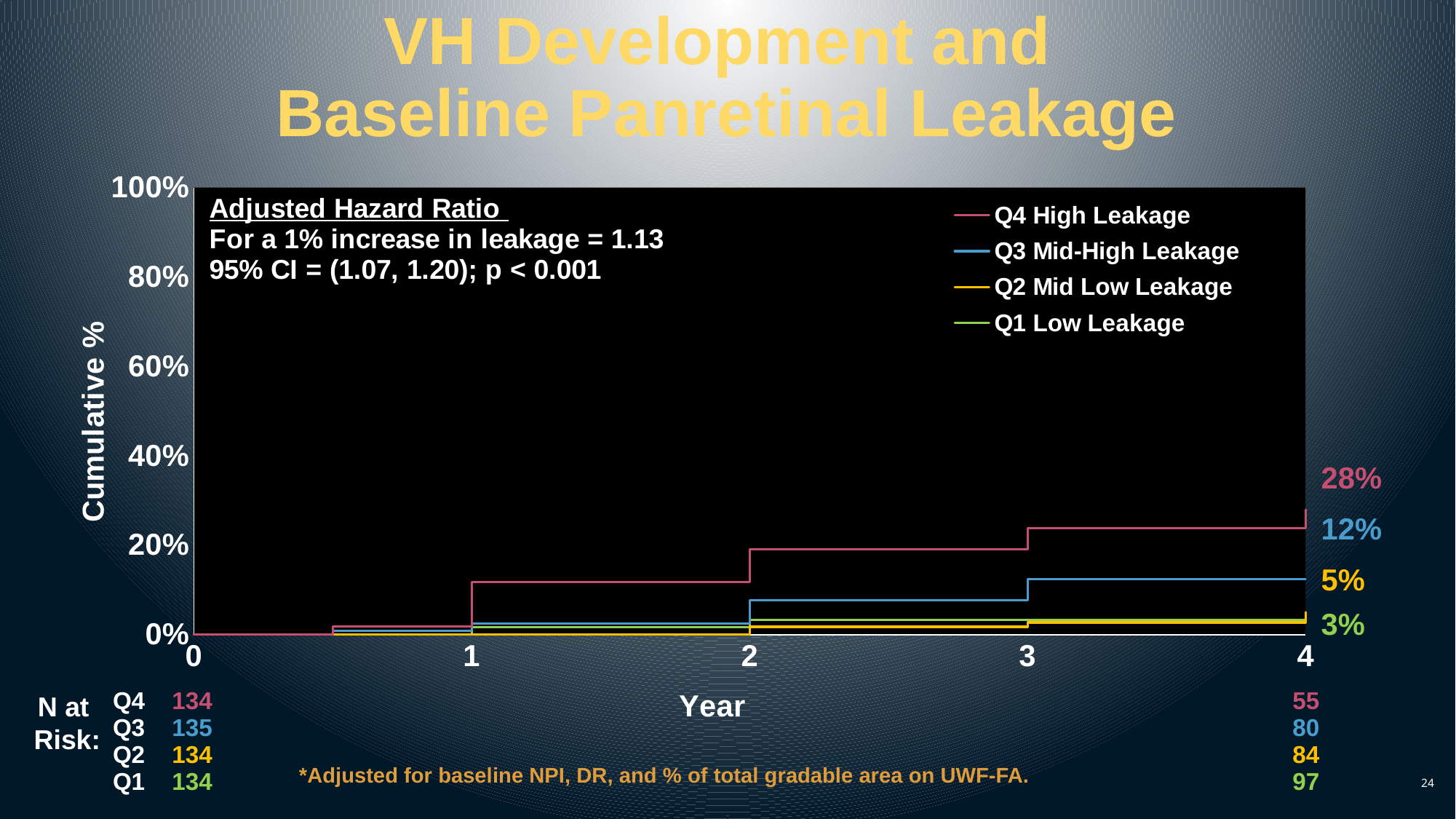
Which group has the highest cumulative % at year 4? Q4 High Leakage What kind of chart is shown on the slide? Line chart (step/cumulative incidence curve) Which group has the lowest cumulative % at year 4? Q1 Low Leakage Does the cumulative % for Q4 High Leakage rise or fall as the year increases? rise Which is larger at year 4: the cumulative % for Q2 Mid Low Leakage or Q1 Low Leakage? Q2 Mid Low Leakage What is the cumulative % at year 4 for the Q3 Mid-High Leakage group? 12% What is the cumulative % at year 4 for the Q4 High Leakage group? 28% What is the cumulative % at year 4 for the Q1 Low Leakage group? 3% How many series does the legend list? 4 What is the number at risk for Q3 at year 0? 135 What is the difference between the year-4 cumulative % of Q4 High Leakage and Q3 Mid-High Leakage? 16% Is the cumulative % for Q4 High Leakage at year 3 greater or less than 40%? less